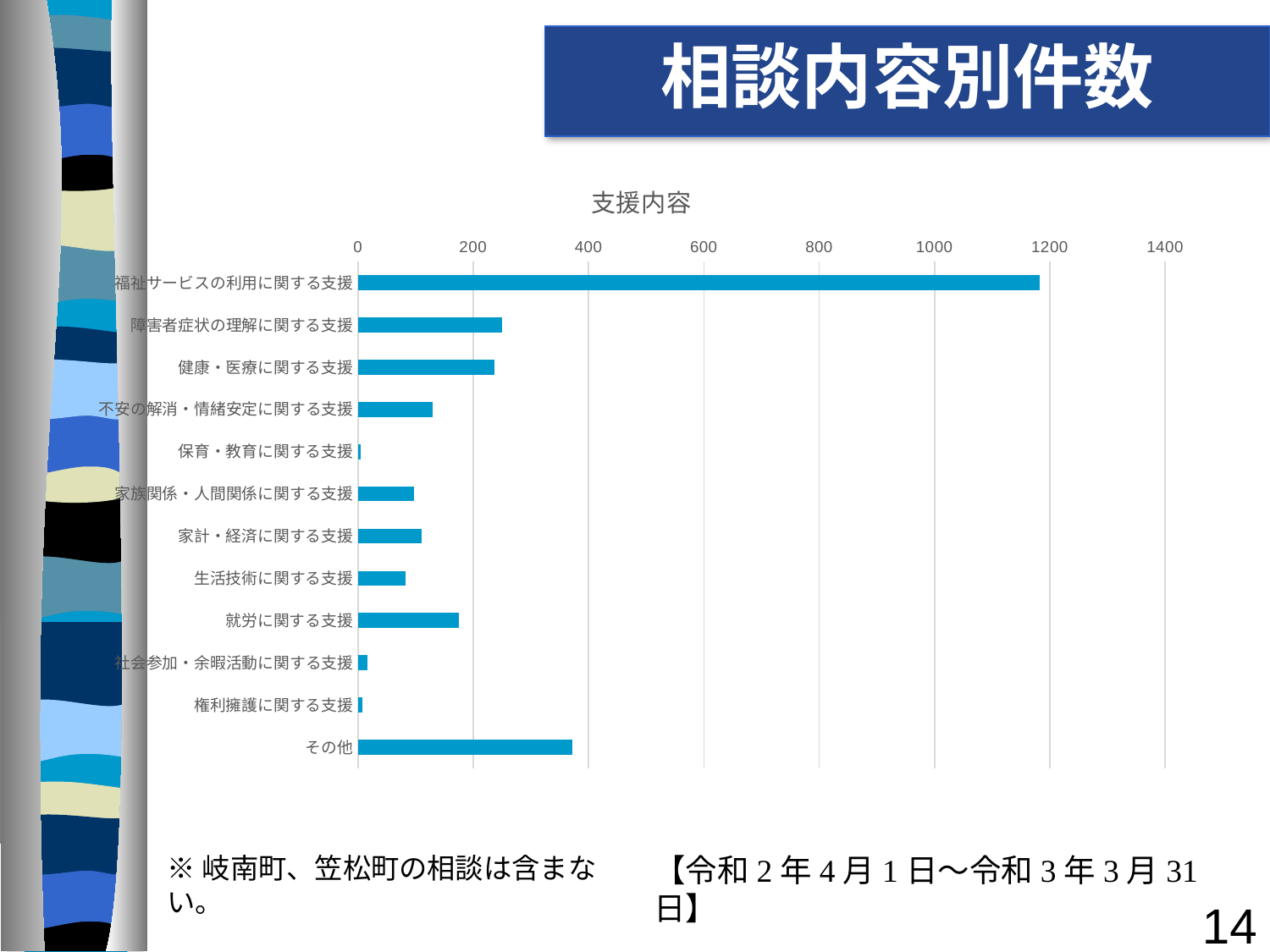
Which is larger, the value for その他 or the value for 就労に関する支援? その他 What kind of chart is shown on the slide? bar chart Is the value for 就労に関する支援 greater or less than 200? less Is the value for その他 greater or less than 200? greater Is the value for 福祉サービスの利用に関する支援 greater or less than 1200? less How many categories are plotted in the chart? 12 What is the title of the chart? 支援内容 Which category has the highest value? 福祉サービスの利用に関する支援 Which is larger, the value for 就労に関する支援 or the value for 生活技術に関する支援? 就労に関する支援